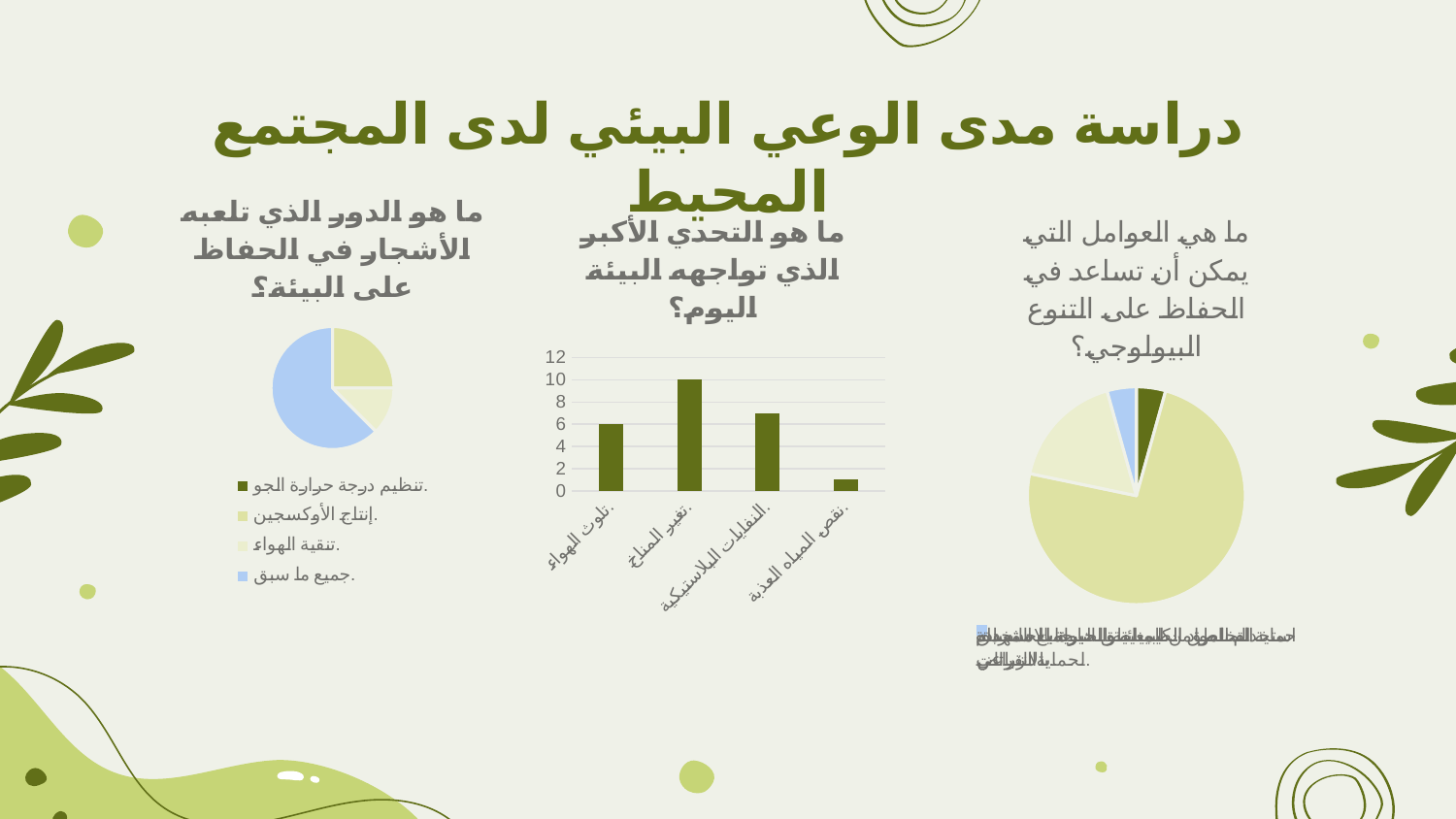
How many entries does the legend of the left pie chart list? 4 How many categories are shown on the x axis of the middle bar chart? 4 In the middle bar chart, is the value for "النفايات البلاستيكية" greater or less than 8? less In the middle bar chart, what is the value for "تلوث الهواء"? 6 In the middle bar chart, what is the difference between the values for "تغير المناخ" and "تلوث الهواء"? 4 In the left pie chart titled "ما هو الدور الذي تلعبه الأشجار في الحفاظ على البيئة؟", which legend entry corresponds to the largest slice? جميع ما سبق In the middle bar chart, which category has the lowest value? نقص المياه العذبة In the middle bar chart, which category has the highest value? تغير المناخ In the middle bar chart, is the value for "نقص المياه العذبة" greater or less than 2? less In the middle bar chart, what is the value for "تغير المناخ"? 10 In the middle chart titled "ما هو التحدي الأكبر الذي تواجهه البيئة اليوم؟", what kind of chart is shown? Bar chart In the middle bar chart, which is larger: the value for "تلوث الهواء" or the value for "النفايات البلاستيكية"? النفايات البلاستيكية